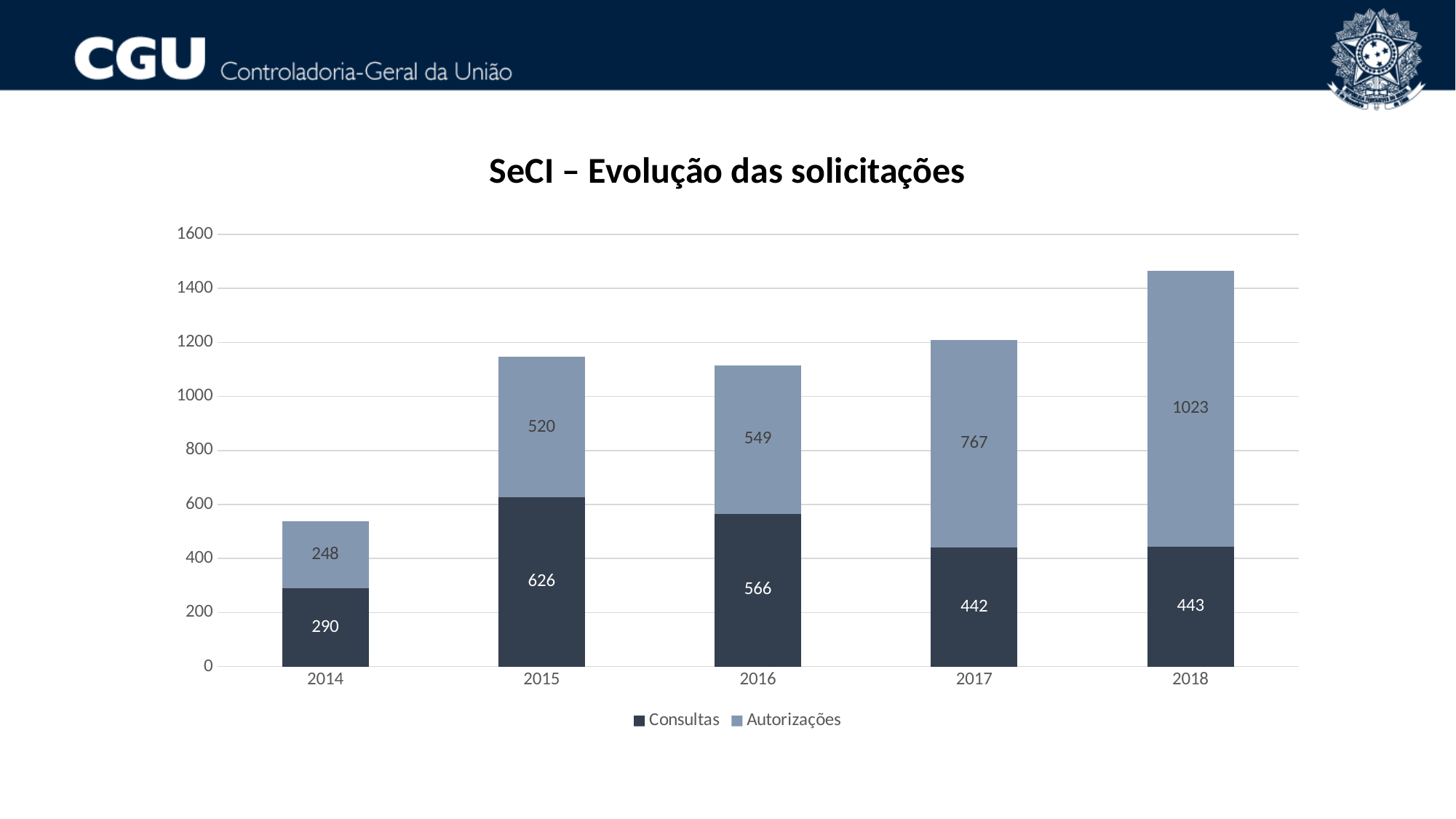
Which year has the lowest value for Autorizações? 2014 How many years are shown on the x axis? 5 What is the value for Autorizações in 2014? 248 How many series does the legend list? 2 What is the value for Autorizações in 2018? 1023 Which year has the highest value for Consultas? 2015 What is the value for Consultas in 2015? 626 Is the total of the stacked bar for 2014 greater or less than 600? less Which is larger in 2016: Consultas or Autorizações? Consultas What is the total of the stacked bar for 2018? 1466 What is the difference between Autorizações and Consultas in 2018? 580 Do the values for Autorizações rise or fall from 2014 to 2018? rise